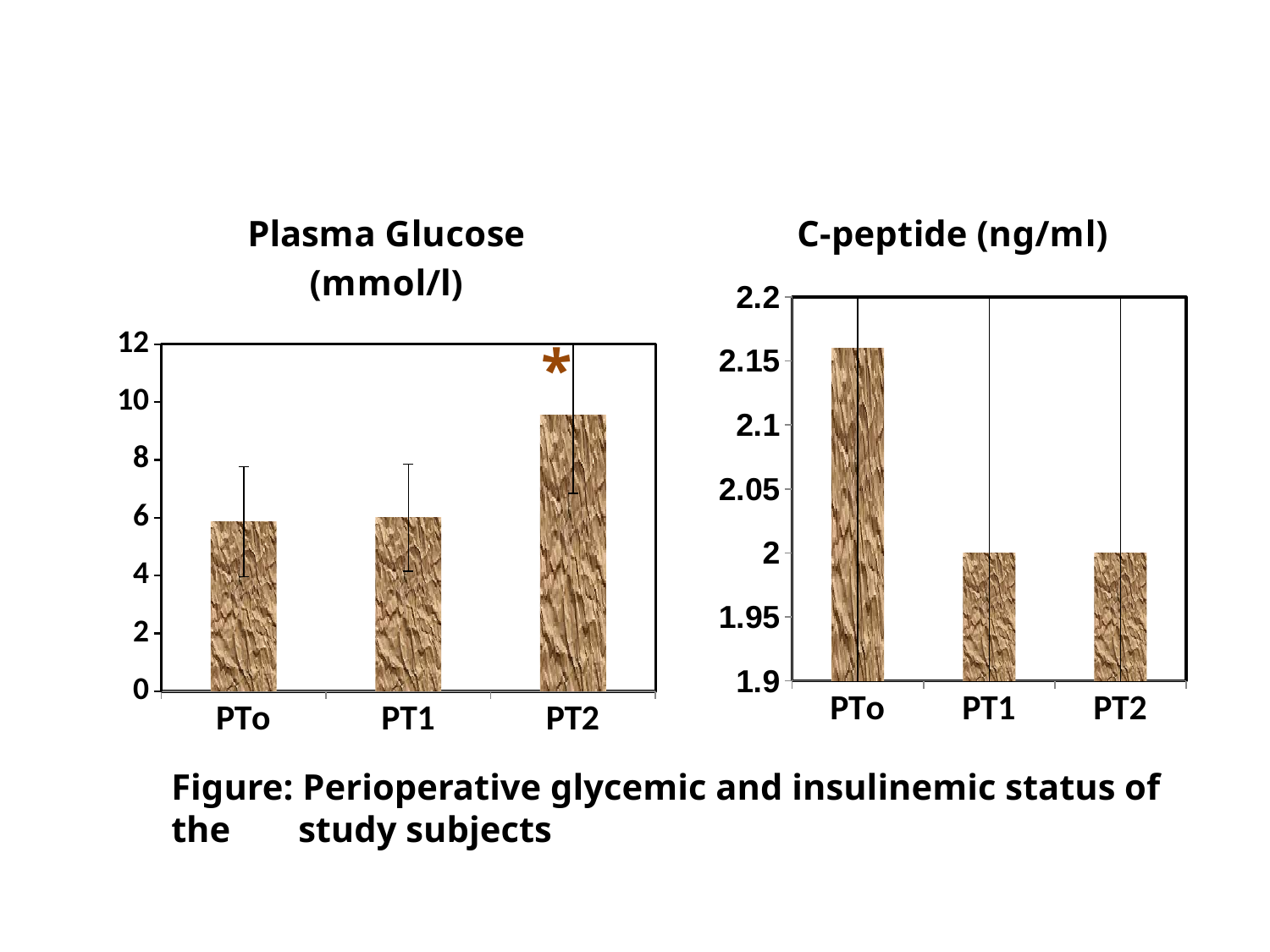
In the Plasma Glucose (mmol/l) chart, which category has the highest value? PT2 How many categories are shown in the Plasma Glucose (mmol/l) chart? 3 What kind of chart is the C-peptide (ng/ml) chart? bar chart In the Plasma Glucose (mmol/l) chart, which is larger, the value for PTo or the value for PT2? PT2 In the Plasma Glucose (mmol/l) chart, is the value for PT2 greater or less than 8? greater In the C-peptide (ng/ml) chart, do the values rise or fall from PTo to PT2? fall In the C-peptide (ng/ml) chart, what is the value for PT1? 2 In the C-peptide (ng/ml) chart, is the value for PTo greater or less than 2.1? greater In the Plasma Glucose (mmol/l) chart, which bar is marked with an asterisk? PT2 In the C-peptide (ng/ml) chart, which is larger, the value for PTo or the value for PT1? PTo In the C-peptide (ng/ml) chart, which category has the highest value? PTo In the Plasma Glucose (mmol/l) chart, is the value for PTo greater or less than 8? less